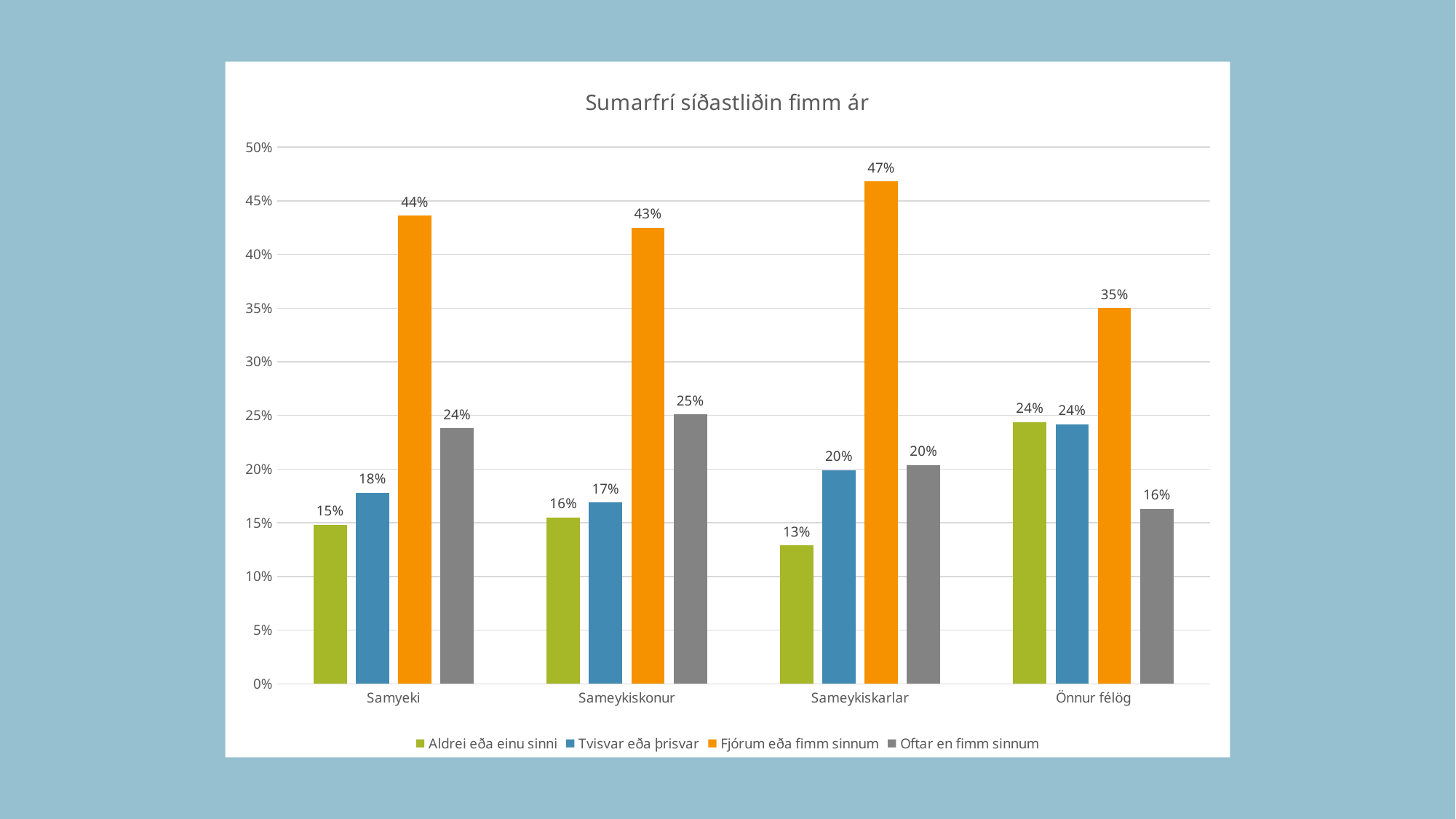
What is the value for "Aldrei eða einu sinni" in the Önnur félög category? 24% Which category has the highest value for "Fjórum eða fimm sinnum"? Sameykiskarlar What kind of chart is shown on the slide? Bar chart How many categories are shown on the x axis? 4 Is the value for "Fjórum eða fimm sinnum" in the Samyeki category greater or less than 40%? greater What is the value for "Oftar en fimm sinnum" in the Sameykiskonur category? 25% How many series does the legend list? 4 What is the difference between the "Fjórum eða fimm sinnum" values for Sameykiskarlar and Önnur félög? 12% Which is larger: the "Oftar en fimm sinnum" value for Samyeki or for Önnur félög? Samyeki What is the title of the chart? Sumarfrí síðastliðin fimm ár Which category has the lowest value for "Aldrei eða einu sinni"? Sameykiskarlar What is the value for "Fjórum eða fimm sinnum" in the Sameykiskarlar category? 47%